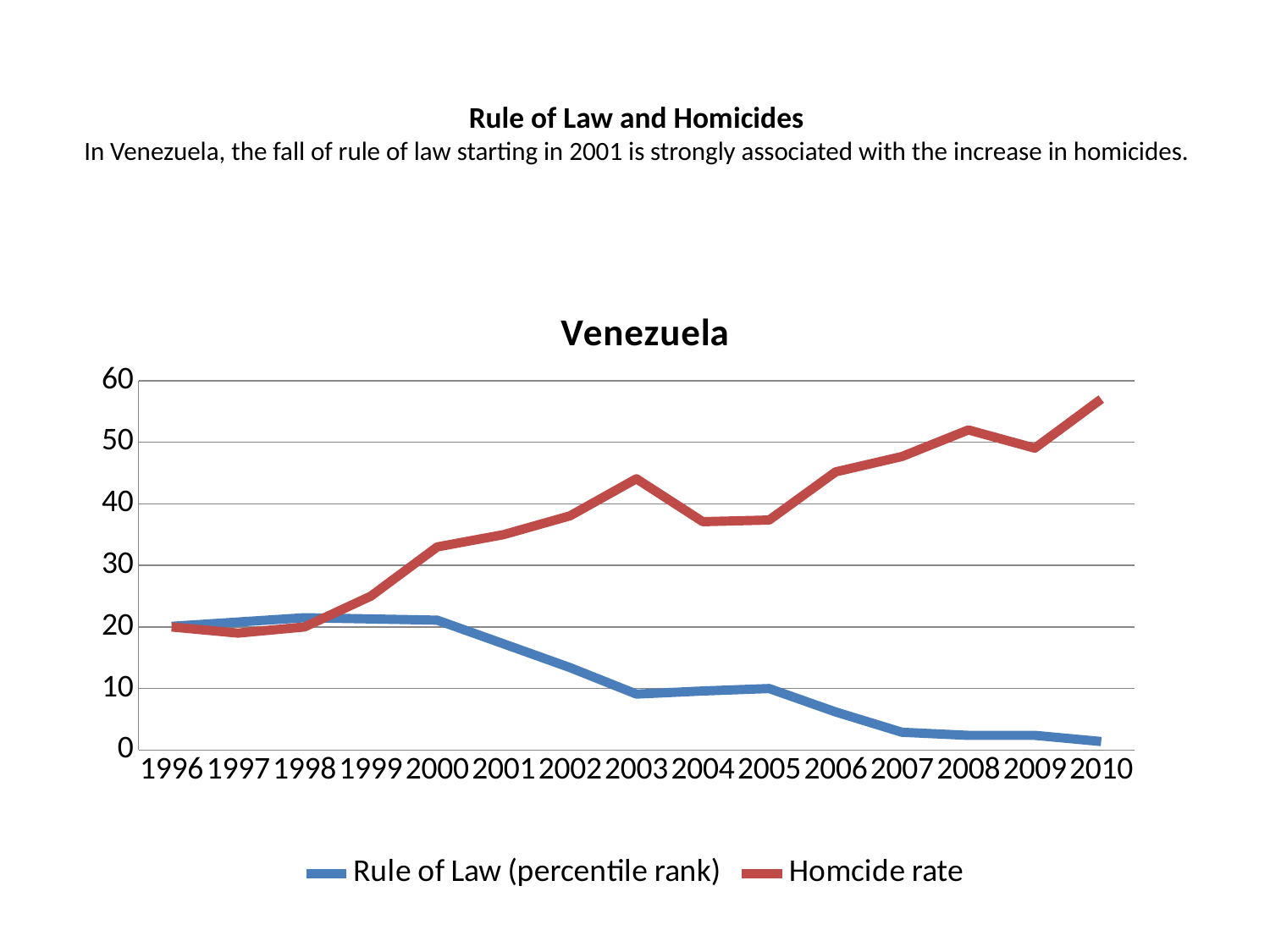
In 2005, which series has the larger value, Rule of Law (percentile rank) or Homcide rate? Homcide rate What kind of chart is shown on the slide? line chart How many series does the legend list? 2 Does the Homcide rate series rise or fall overall from 1996 to 2010? rise Is the Homcide rate value for 2010 greater or less than 50? greater Does the Rule of Law (percentile rank) series rise or fall overall from 2000 to 2010? fall In which year is the Homcide rate highest? 2010 Is the Rule of Law (percentile rank) value for 2007 greater or less than 10? less How many years are plotted along the x axis? 15 Which series is drawn in red? Homcide rate What is the title of the chart? Venezuela In which year is the Rule of Law (percentile rank) lowest? 2010